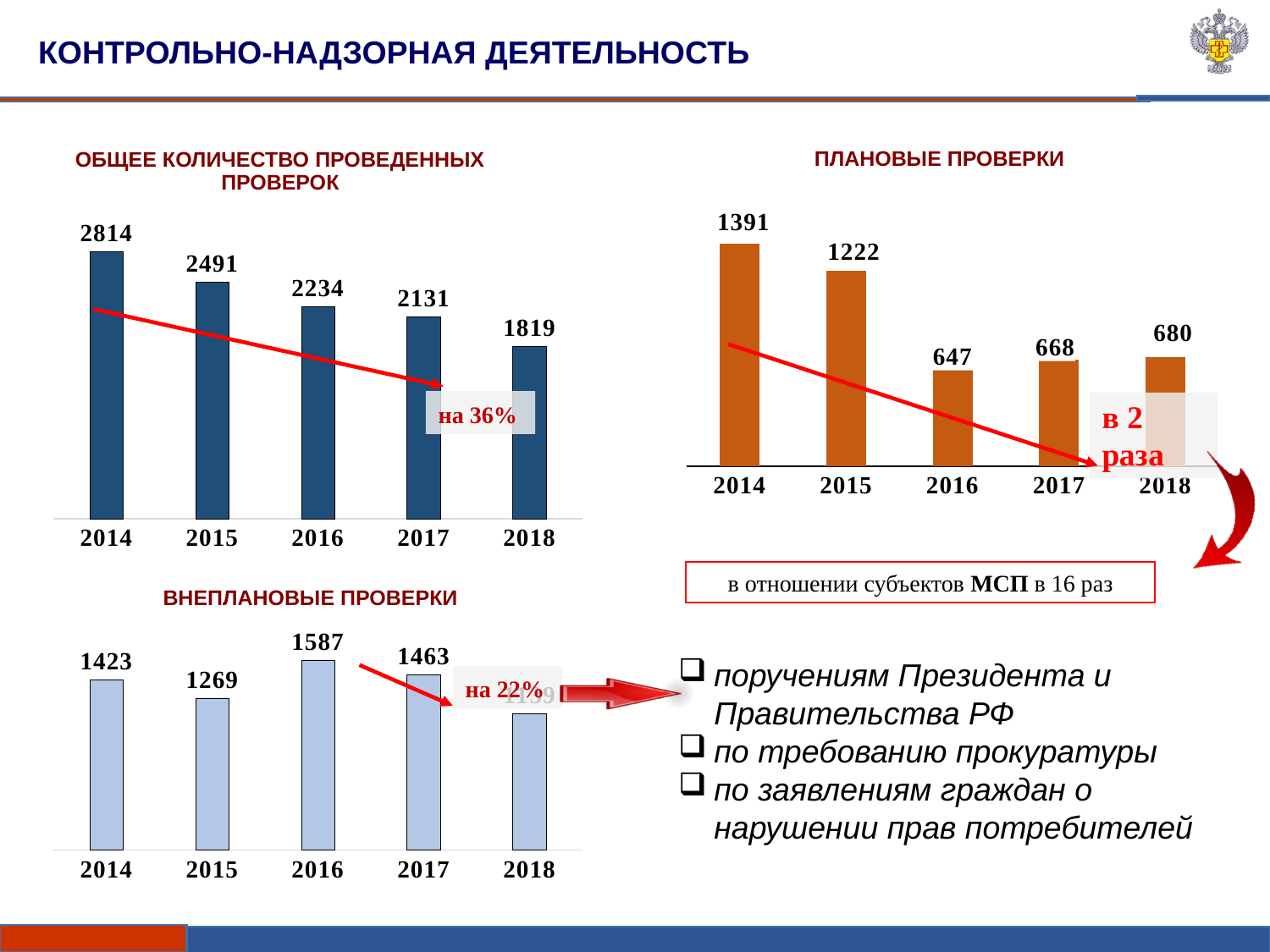
In the chart titled "ОБЩЕЕ КОЛИЧЕСТВО ПРОВЕДЕННЫХ ПРОВЕРОК", which year has the lowest value? 2018 In the chart titled "ПЛАНОВЫЕ ПРОВЕРКИ", which year has the lowest value? 2016 In the chart titled "ПЛАНОВЫЕ ПРОВЕРКИ", what is the difference between the values for 2014 and 2018? 711 In the chart titled "ВНЕПЛАНОВЫЕ ПРОВЕРКИ", what is the value for 2016? 1587 How many years are shown on the x axis of the chart titled "ВНЕПЛАНОВЫЕ ПРОВЕРКИ"? 5 In the chart titled "ВНЕПЛАНОВЫЕ ПРОВЕРКИ", which is larger, the value for 2014 or the value for 2015? 2014 In the chart titled "ОБЩЕЕ КОЛИЧЕСТВО ПРОВЕДЕННЫХ ПРОВЕРОК", do the values rise or fall from 2014 to 2018? fall In the chart titled "ПЛАНОВЫЕ ПРОВЕРКИ", which year has the highest value? 2014 In the chart titled "ОБЩЕЕ КОЛИЧЕСТВО ПРОВЕДЕННЫХ ПРОВЕРОК", what is the value for 2014? 2814 In the chart titled "ОБЩЕЕ КОЛИЧЕСТВО ПРОВЕДЕННЫХ ПРОВЕРОК", what is the value for 2018? 1819 In the chart titled "ПЛАНОВЫЕ ПРОВЕРКИ", what is the value for 2015? 1222 In the chart titled "ОБЩЕЕ КОЛИЧЕСТВО ПРОВЕДЕННЫХ ПРОВЕРОК", what is the difference between the values for 2014 and 2018? 995